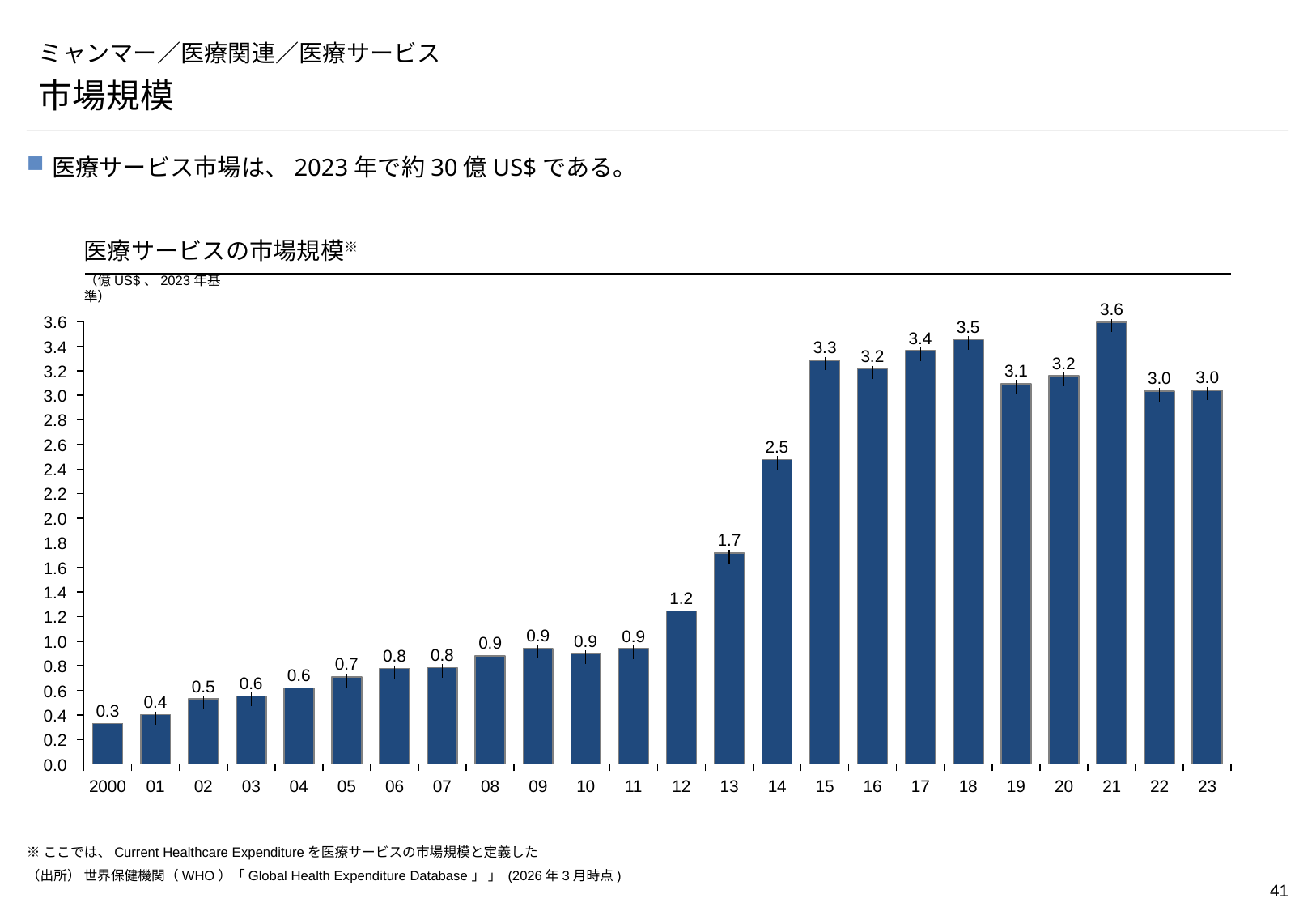
What kind of chart is shown on the slide? bar chart Which year has the lowest value in the chart? 2000 What is the value for 2023 in the chart? 3.0 What is the title of the chart? 医療サービスの市場規模 Which is larger, the value for 2015 or the value for 2016? 2015 Which year has the highest value in the chart? 21 What is the value for 2014 in the chart? 2.5 What is the difference between the value for 2021 and the value for 2000? 3.3 How many years (bars) are shown in the chart? 24 Is the value for 2014 greater or less than 2.0? greater What is the value for 2013 in the chart? 1.7 Do the values generally rise or fall from 2000 to 2021? rise